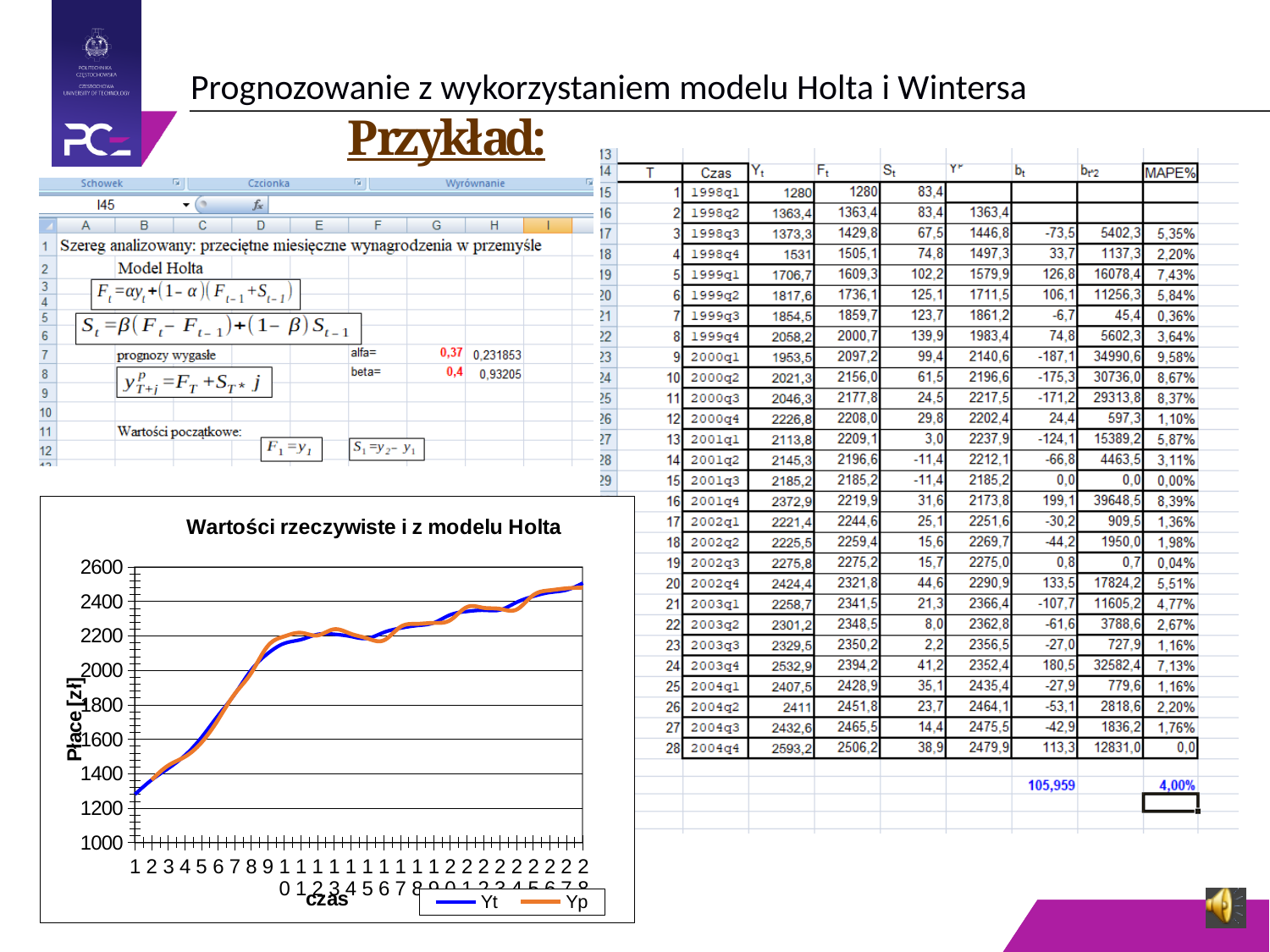
What is the label of the y axis of the chart? Płace [zł] Is the value of Yp at time 15 greater or less than 2000? greater Is the value of Yt at time 1 greater or less than 1400? less Is the value of Yp at time 3 greater or less than 1600? less How many time points are plotted along the x axis of the chart? 28 Do the values of the Yt series generally rise or fall along the x axis? rise How many series does the legend of the chart list? 2 What is the title of the chart? Wartości rzeczywiste i z modelu Holta What kind of chart is shown on the slide? line chart